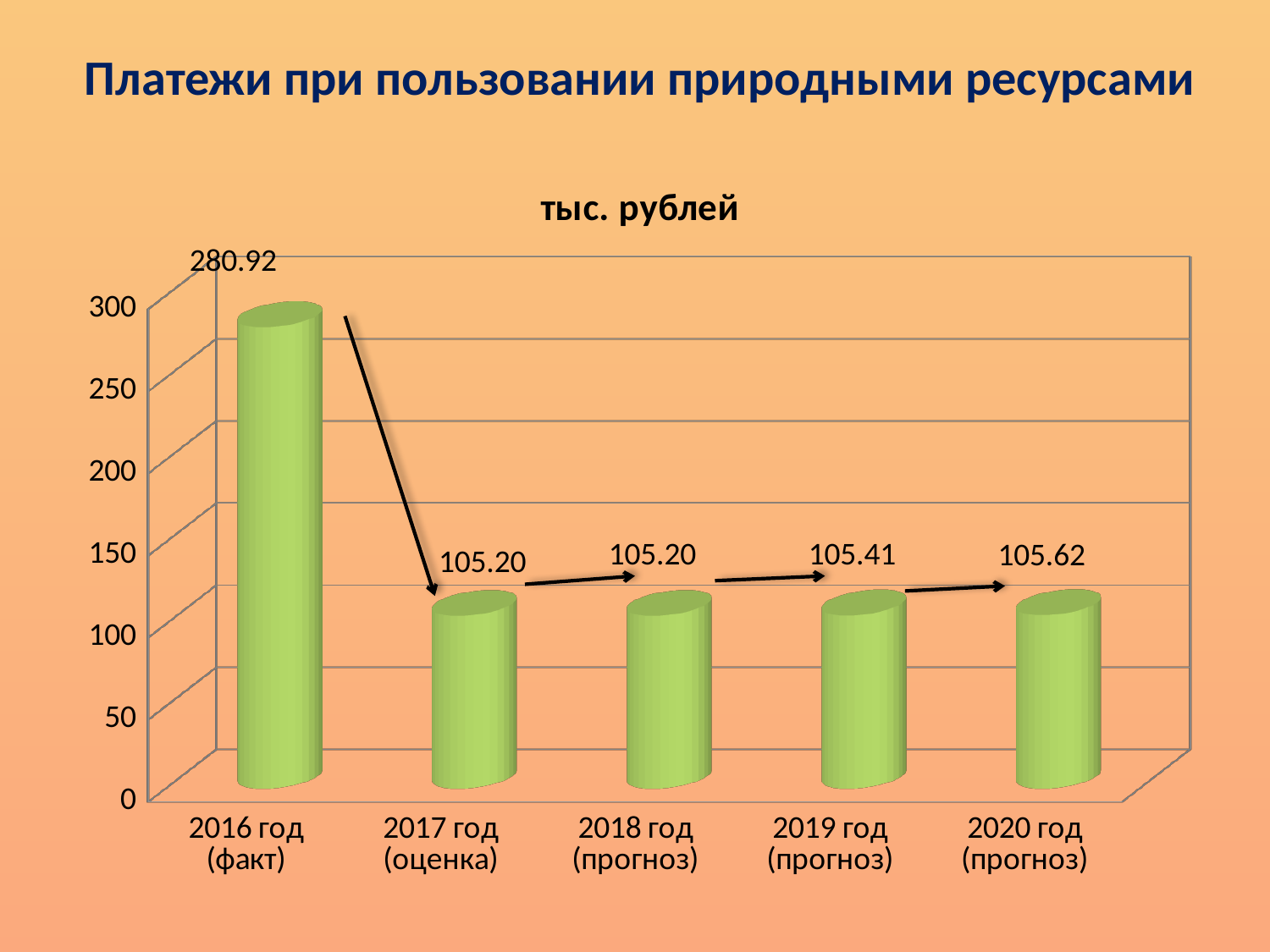
What is the value for 2016 год (факт)? 280.92 How many categories are shown on the x axis? 5 What kind of chart is shown on the slide? bar chart What is the value for 2020 год (прогноз)? 105.62 Which is larger, the value for 2016 год (факт) or the value for 2018 год (прогноз)? 2016 год (факт) What is the value for 2019 год (прогноз)? 105.41 What is the difference between the values for 2020 год (прогноз) and 2019 год (прогноз)? 0.21 What is the value for 2017 год (оценка)? 105.20 Which category has the highest value? 2016 год (факт) What is the chart title shown above the plot area? тыс. рублей Is the value for 2018 год (прогноз) greater or less than 150? less What is the difference between the values for 2016 год (факт) and 2017 год (оценка)? 175.72